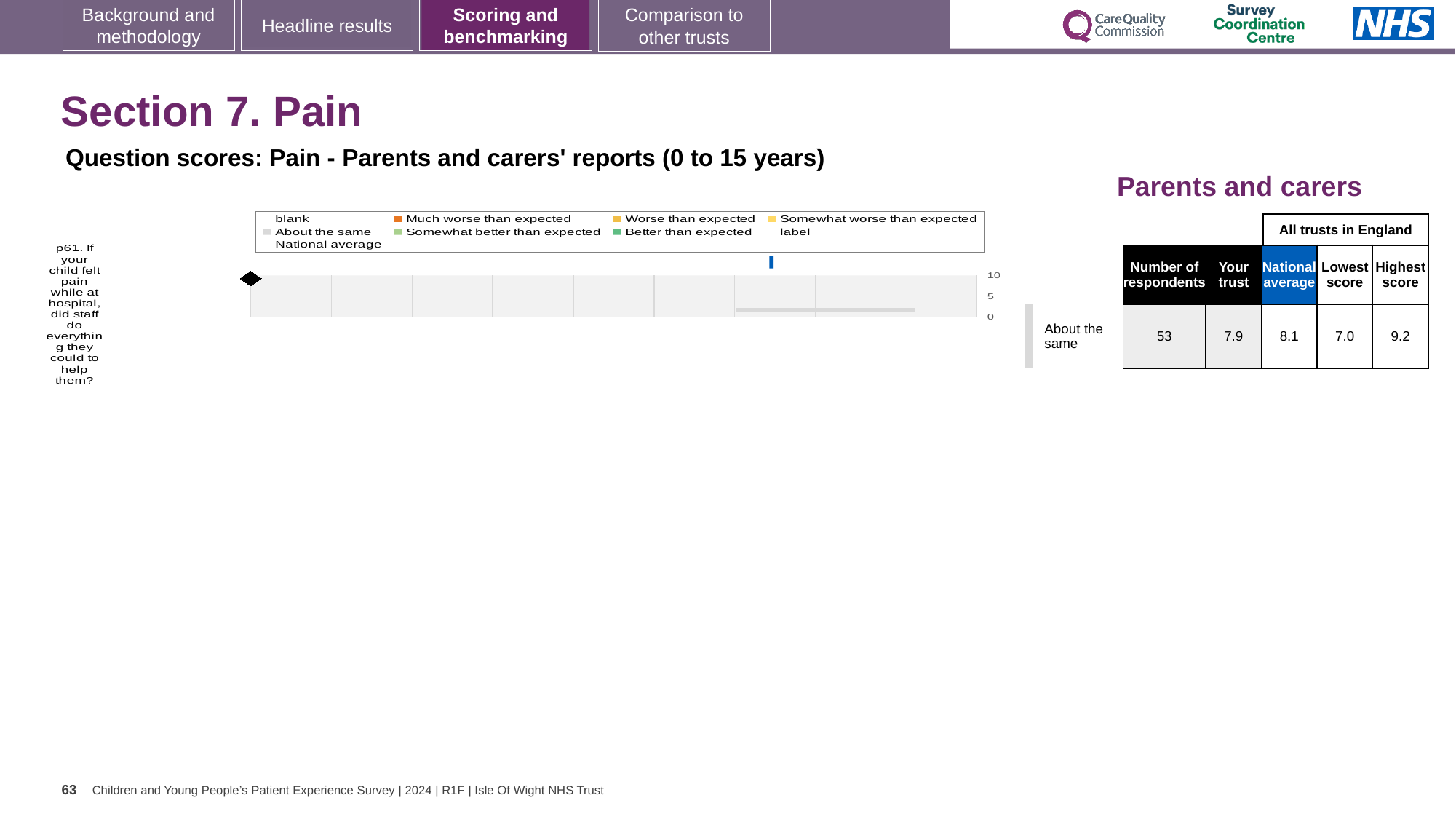
What is the difference between the highest score (9.2) and the lowest score (7.0) for p61 in the table beside the chart? 2.2 What kind of chart is shown on the slide? bar chart According to the table beside the chart, what is the national average score for p61? 8.1 According to the table beside the chart, what is the 'Your trust' score for p61? 7.9 How many survey questions (categories) are plotted in the chart? 1 Which is larger for p61: the 'Your trust' score or the national average? National average Which benchmark category is the p61 result assigned to, as shown beside the chart? About the same Which question number is plotted in the chart? p61 How many entries does the chart's legend list? 9 According to the table beside the chart, how many respondents answered p61? 53 According to the table beside the chart, what is the lowest score among all trusts in England for p61? 7.0